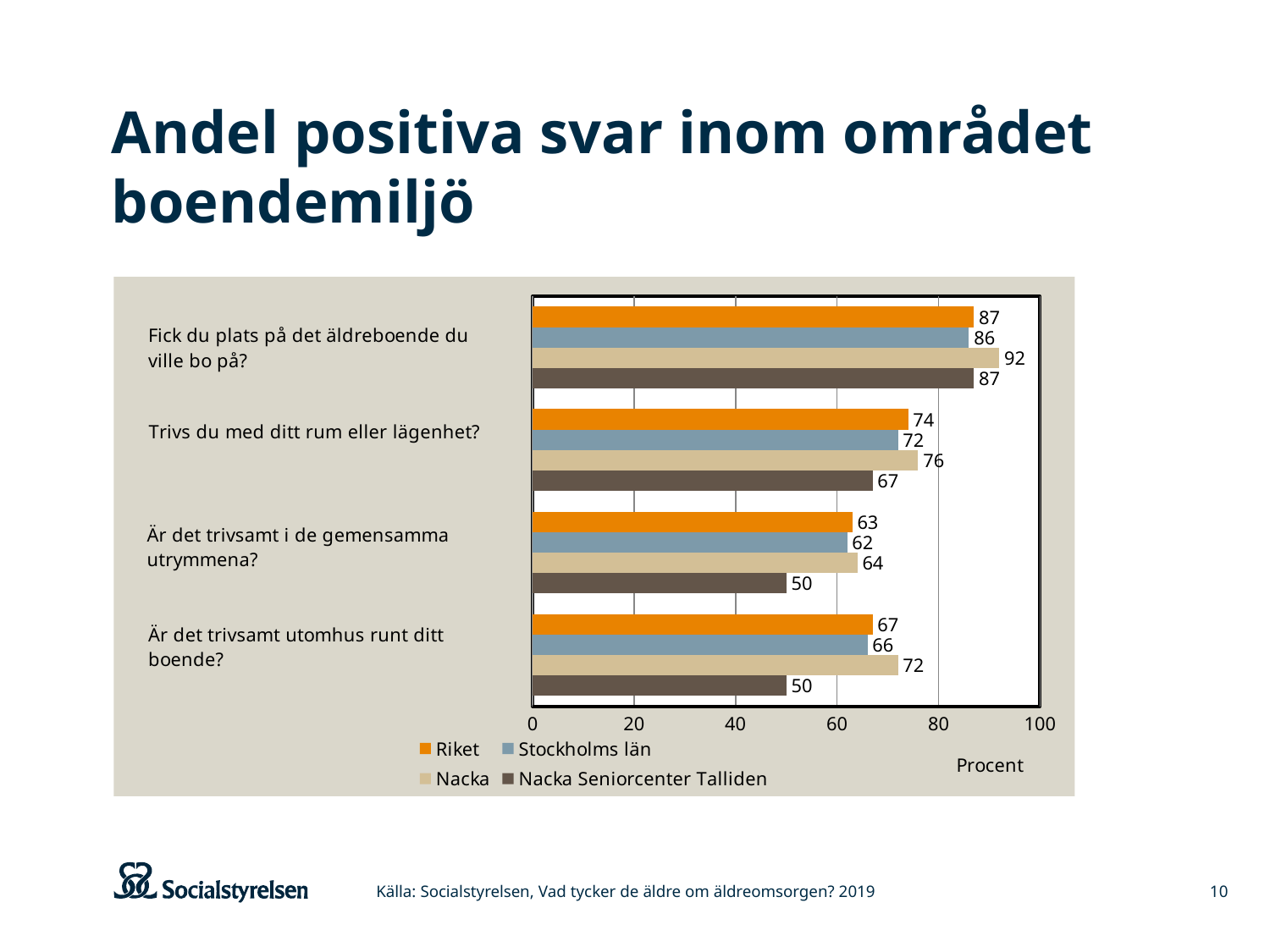
What is the difference between Nacka and Nacka Seniorcenter Talliden on "Är det trivsamt i de gemensamma utrymmena?"? 14 Which series has the highest value on "Fick du plats på det äldreboende du ville bo på?"? Nacka Which series has the lowest value on "Är det trivsamt utomhus runt ditt boende?"? Nacka Seniorcenter Talliden How many question categories are shown on the chart? 4 What is the value for Nacka on "Fick du plats på det äldreboende du ville bo på?"? 92 What kind of chart is shown on the slide? bar chart What is the value for Nacka Seniorcenter Talliden on "Trivs du med ditt rum eller lägenhet?"? 67 How many series does the legend list? 4 Which is larger on "Trivs du med ditt rum eller lägenhet?": Riket or Nacka? Nacka What is the value for Stockholms län on "Är det trivsamt i de gemensamma utrymmena?"? 62 Is the value for Nacka Seniorcenter Talliden on "Är det trivsamt i de gemensamma utrymmena?" greater or less than 60? less What is the value for Riket on "Är det trivsamt utomhus runt ditt boende?"? 67